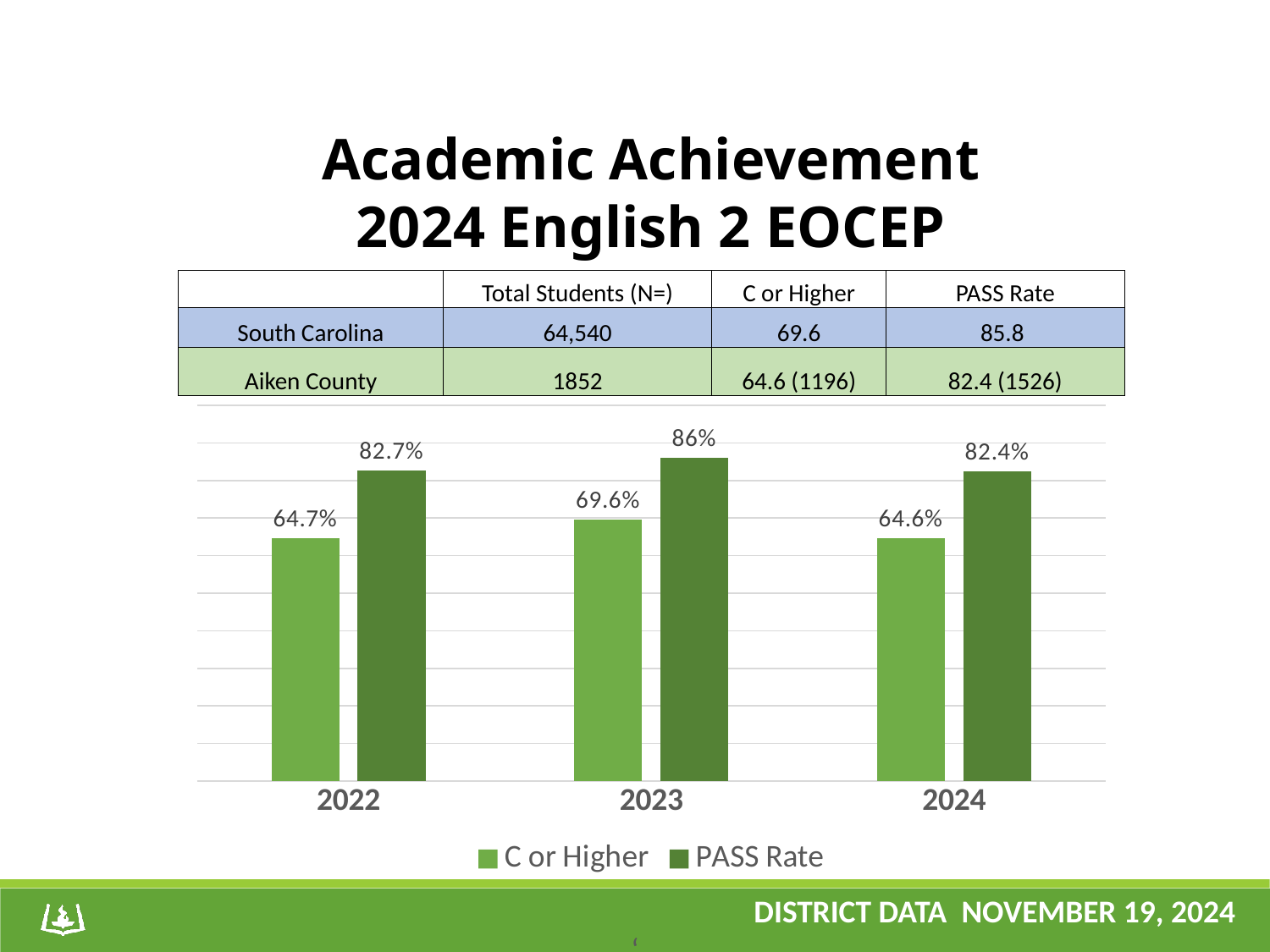
Which is larger in 2022, the C or Higher value or the PASS Rate? PASS Rate What is the PASS Rate for 2024? 82.4% What is the difference between the PASS Rate and the C or Higher value in 2024? 17.8% How many series does the chart legend list? 2 Does the C or Higher value rise or fall from 2023 to 2024? Fall Which series is shown in the darker green bars? PASS Rate What is the C or Higher value for 2022? 64.7% Which year has the lowest PASS Rate? 2024 Which year has the highest C or Higher value? 2023 What is the PASS Rate for 2023? 86% How many years are shown on the x axis of the chart? 3 What kind of chart is shown on the slide? Bar chart